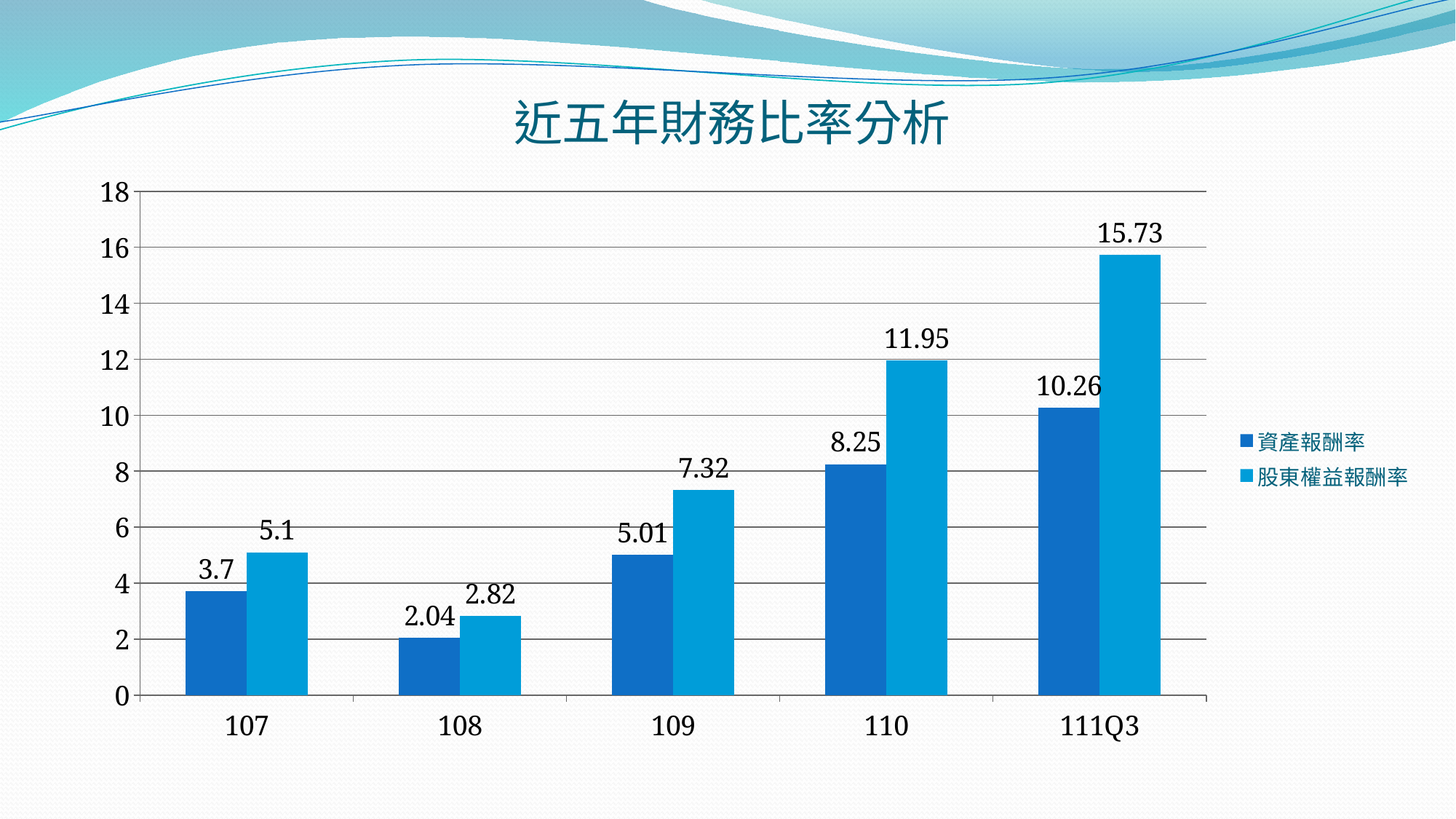
Which category has the highest 股東權益報酬率? 111Q3 How many categories are shown on the x axis? 5 Which category has the lowest 資產報酬率? 108 What is the value of 資產報酬率 for 110? 8.25 How many series does the legend list? 2 What is the title of the chart? 近五年財務比率分析 Does 股東權益報酬率 rise or fall from 108 to 111Q3? rise What is the value of 股東權益報酬率 for 108? 2.82 Which is larger for 107: 資產報酬率 or 股東權益報酬率? 股東權益報酬率 What is the value of 股東權益報酬率 for 111Q3? 15.73 What kind of chart is shown on the slide? bar chart What is the difference between 股東權益報酬率 and 資產報酬率 for 109? 2.31